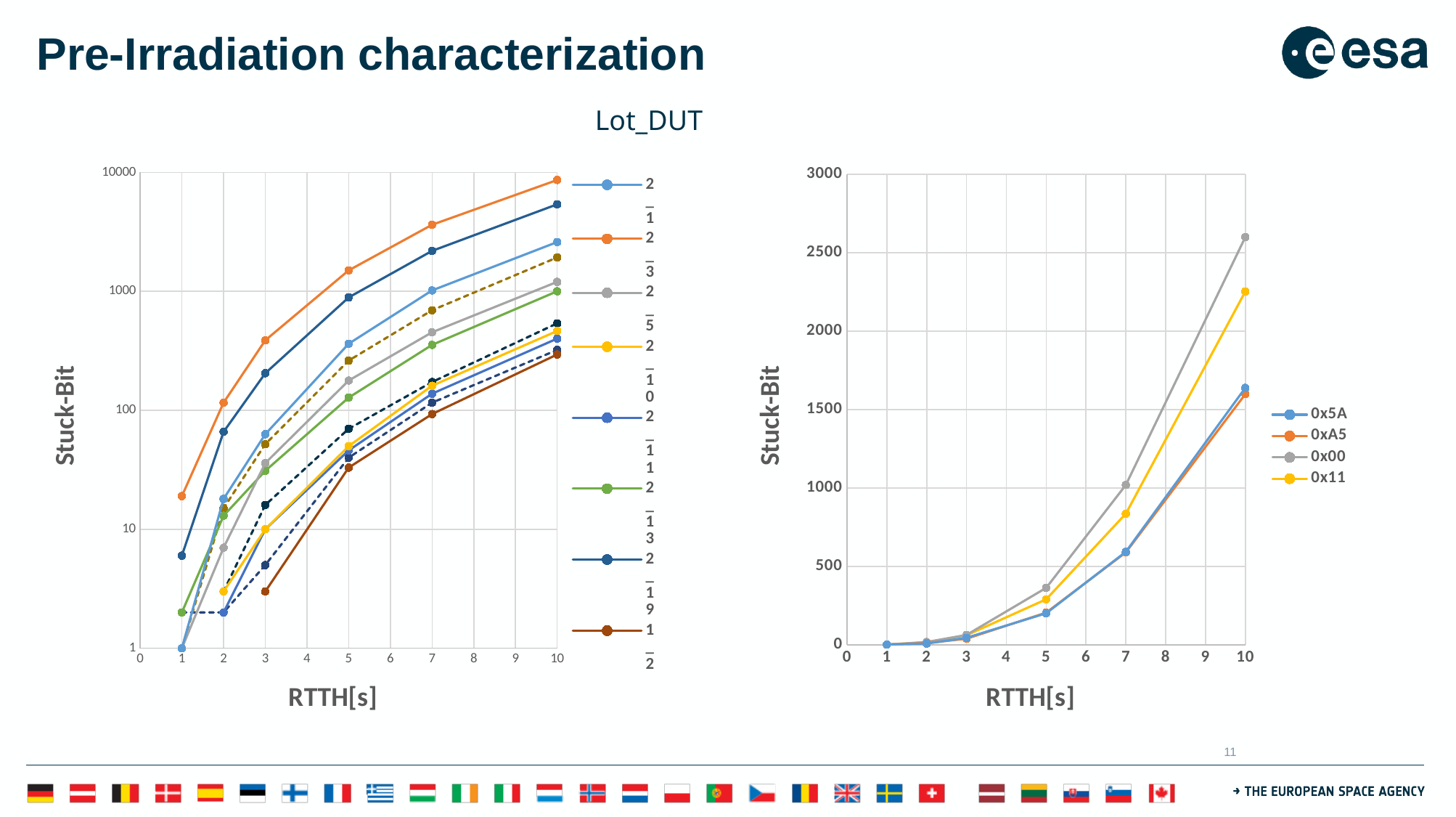
In the right-hand chart, do the Stuck-Bit values rise or fall as RTTH increases? rise How many RTTH data points are plotted per series in the right-hand chart? 6 In the right-hand chart, is the value for 0x11 at RTTH 10 greater or less than 2000? greater What kind of chart is the right-hand chart on the slide? line chart What kind of chart is the left-hand chart titled Lot_DUT? line chart How many series does the legend of the right-hand chart list? 4 In the right-hand chart, which is larger at RTTH 10: the value for 0x00 or the value for 0x11? 0x00 In the right-hand chart, which series has the highest Stuck-Bit value at RTTH 10? 0x00 In the right-hand chart, is the value for 0x5A at RTTH 7 greater or less than 500? greater In the right-hand chart, is the value for 0x00 at RTTH 5 greater or less than 500? less What is the title of the left-hand chart? Lot_DUT